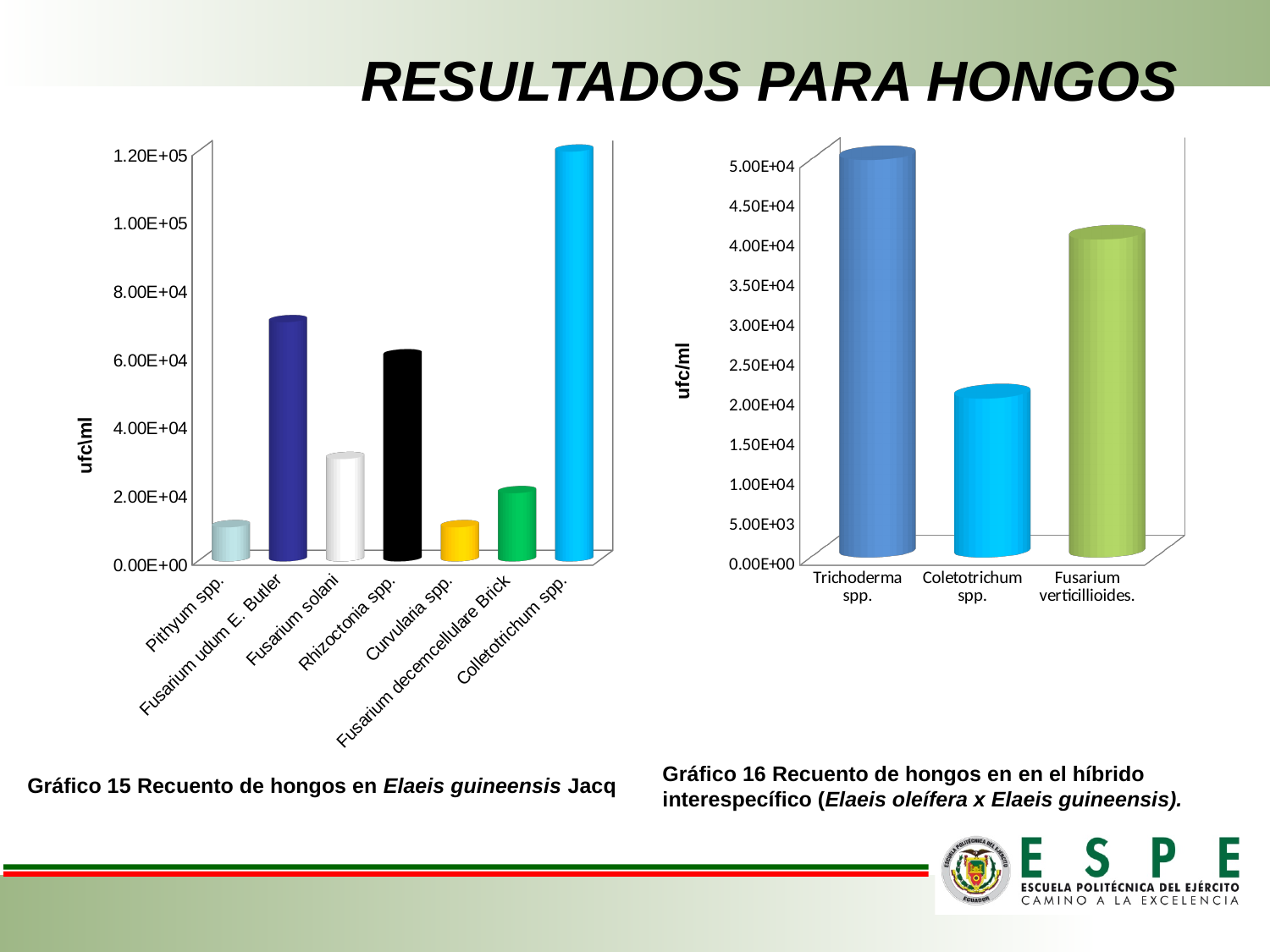
In Gráfico 16 (right chart), how many categories are shown? 3 In Gráfico 16 (right chart), is the value for Fusarium verticillioides greater or less than 3.00E+04? greater What is the y-axis label of Gráfico 16 (right chart)? ufc/ml What type of chart is Gráfico 15 (left chart)? Bar chart In Gráfico 15 (left chart), is the value for Fusarium udum E. Butler greater or less than 6.00E+04? greater In Gráfico 15 (left chart), which category has the highest value? Colletotrichum spp. In Gráfico 15 (left chart), is the value for Colletotrichum spp. greater or less than 1.00E+05? greater In Gráfico 15 (left chart), how many categories are shown on the x axis? 7 In Gráfico 16 (right chart), which category has the highest value? Trichoderma spp. In Gráfico 16 (right chart), which category has the lowest value? Coletotrichum spp. In Gráfico 15 (left chart), which is larger, the value for Rhizoctonia spp. or the value for Fusarium decemcellulare Brick? Rhizoctonia spp.